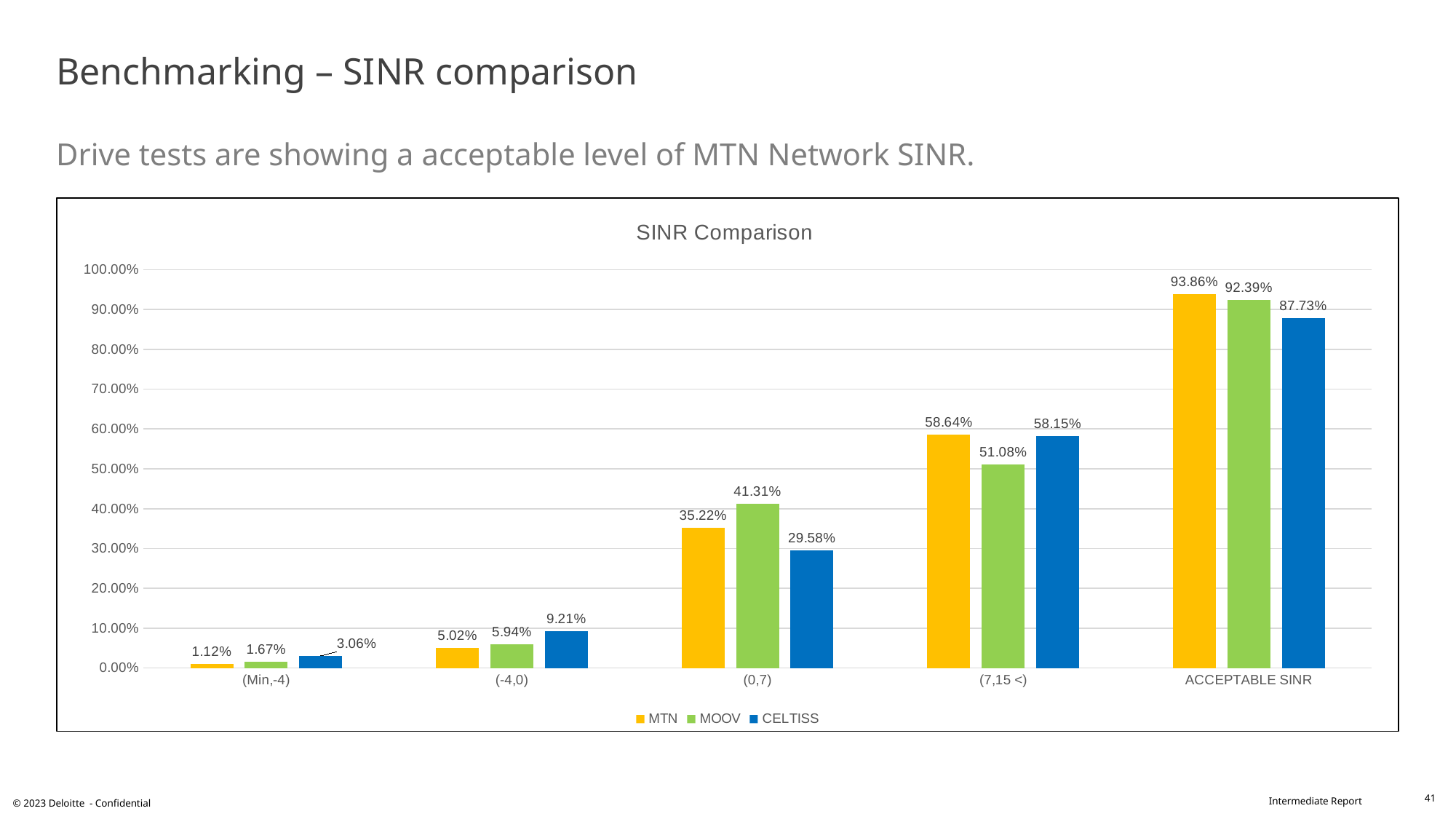
Which operator has the highest value in the (0,7) category? MOOV What is the MTN value for ACCEPTABLE SINR? 93.86% What is the difference between the MTN and CELTISS values for ACCEPTABLE SINR? 6.13% What is the title of the chart? SINR Comparison Which operator has the lowest value for ACCEPTABLE SINR? CELTISS What is the MOOV value for the (-4,0) category? 5.94% How many series does the legend list? 3 What is the CELTISS value for the (0,7) category? 29.58% How many categories are shown on the x axis? 5 Is the MOOV value for the (0,7) category greater or less than 40.00%? greater What kind of chart is shown? Bar chart Which is larger in the (7,15 <) category, the MTN value or the MOOV value? MTN